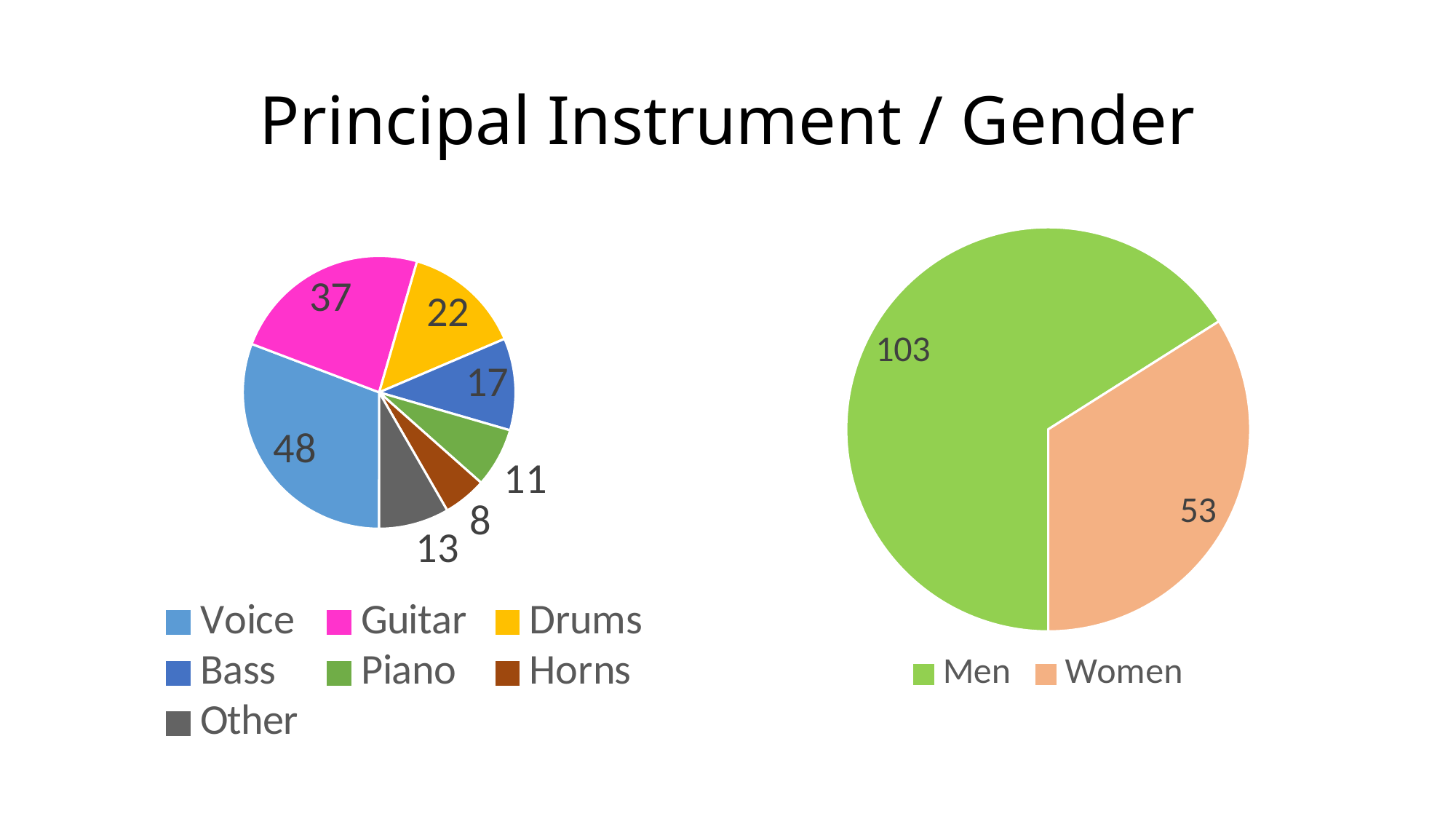
In the left pie chart, which category has the largest slice? Voice What type of chart is the right chart? Pie chart How many categories does the left pie chart show? 7 In the left pie chart, what is the value for Voice? 48 In the left pie chart, which is larger, Other or Piano? Other In the right pie chart, what is the difference between the values for Men and Women? 50 In the left pie chart, which category has the smallest slice? Horns In the right pie chart, what share of the total do Men represent, to the nearest whole percent? 66% In the left pie chart, what is the value for Drums? 22 In the right pie chart, what is the value for Women? 53 In the left pie chart, what is the value for Horns? 8 In the left pie chart, what is the difference between the values for Guitar and Bass? 20